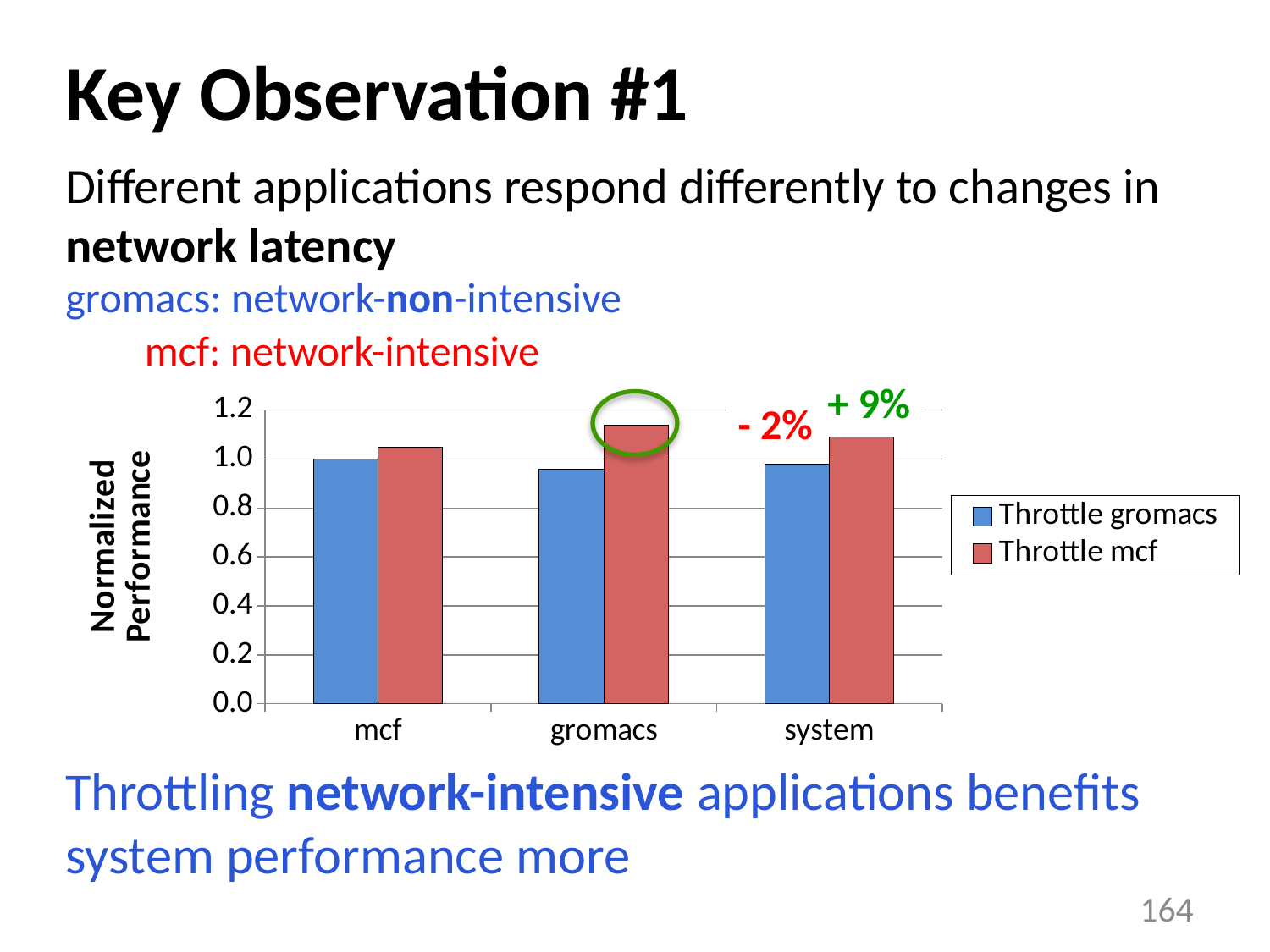
Which category has the highest Throttle mcf value? gromacs How many categories are shown on the x axis of the chart? 3 Is the Throttle gromacs value for gromacs greater or less than 1.0? less What is the title of the chart's y axis? Normalized Performance What is the Throttle gromacs value for mcf? 1.0 What kind of chart is shown on the slide? bar chart Is the Throttle mcf value for system greater or less than 1.0? greater How many series does the chart's legend list? 2 Is the Throttle mcf value for gromacs greater or less than 1.0? greater What percentage change is annotated in green above the system bars? + 9% For the gromacs category, which series has the larger value, Throttle gromacs or Throttle mcf? Throttle mcf